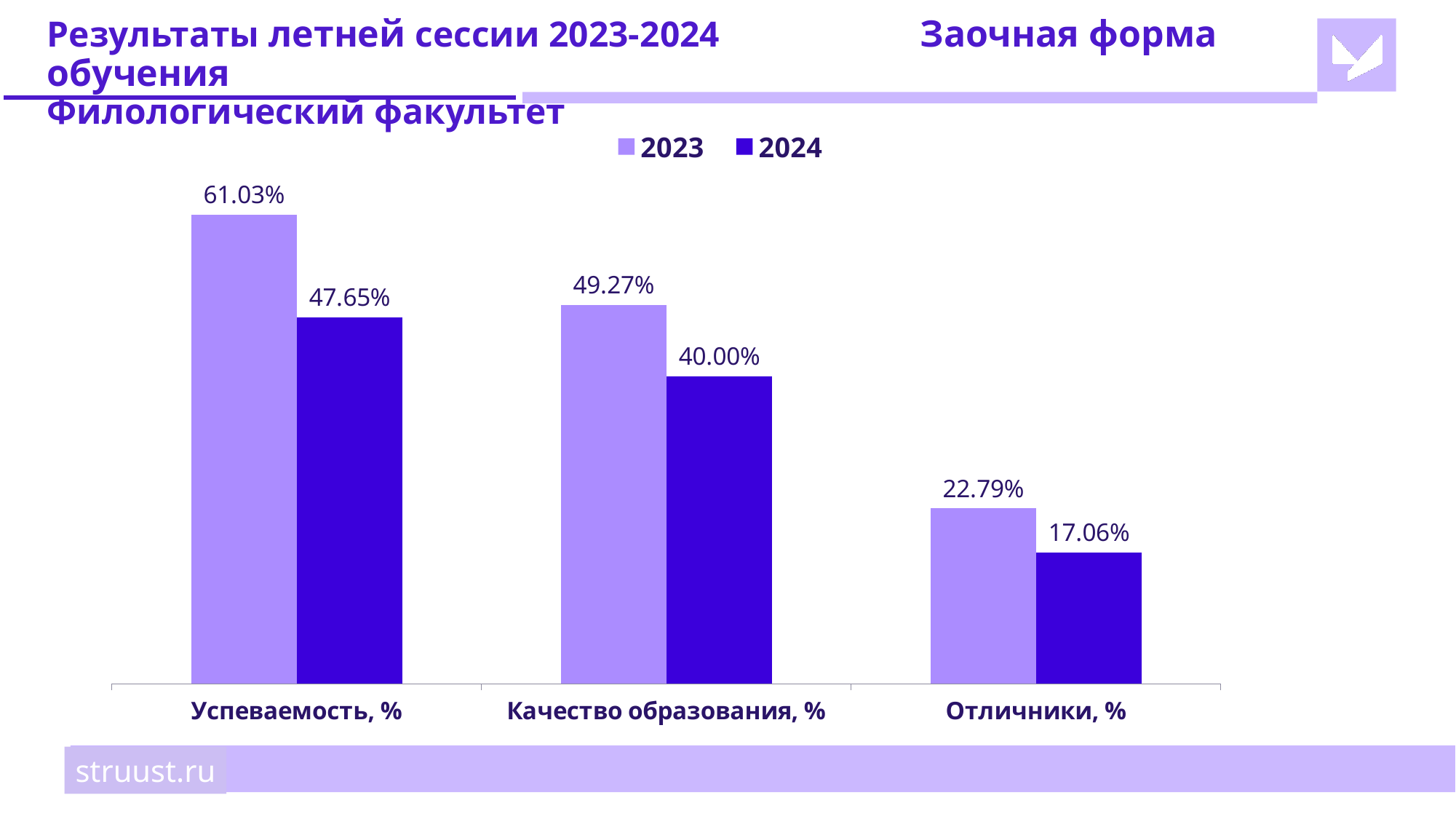
How many series does the legend list? 2 What is the 2023 value for Успеваемость, %? 61.03% For Качество образования, %, which year has the larger value, 2023 or 2024? 2023 What is the 2024 value for Отличники, %? 17.06% Which category has the highest 2023 value? Успеваемость, % What is the 2023 value for Качество образования, %? 49.27% How many categories are shown on the x axis? 3 What is the difference between the 2023 and 2024 values for Отличники, %? 5.73% What kind of chart is shown on the slide? Bar chart Which category has the lowest 2024 value? Отличники, % What is the difference between the 2023 and 2024 values for Успеваемость, %? 13.38% What is the 2024 value for Качество образования, %? 40.00%